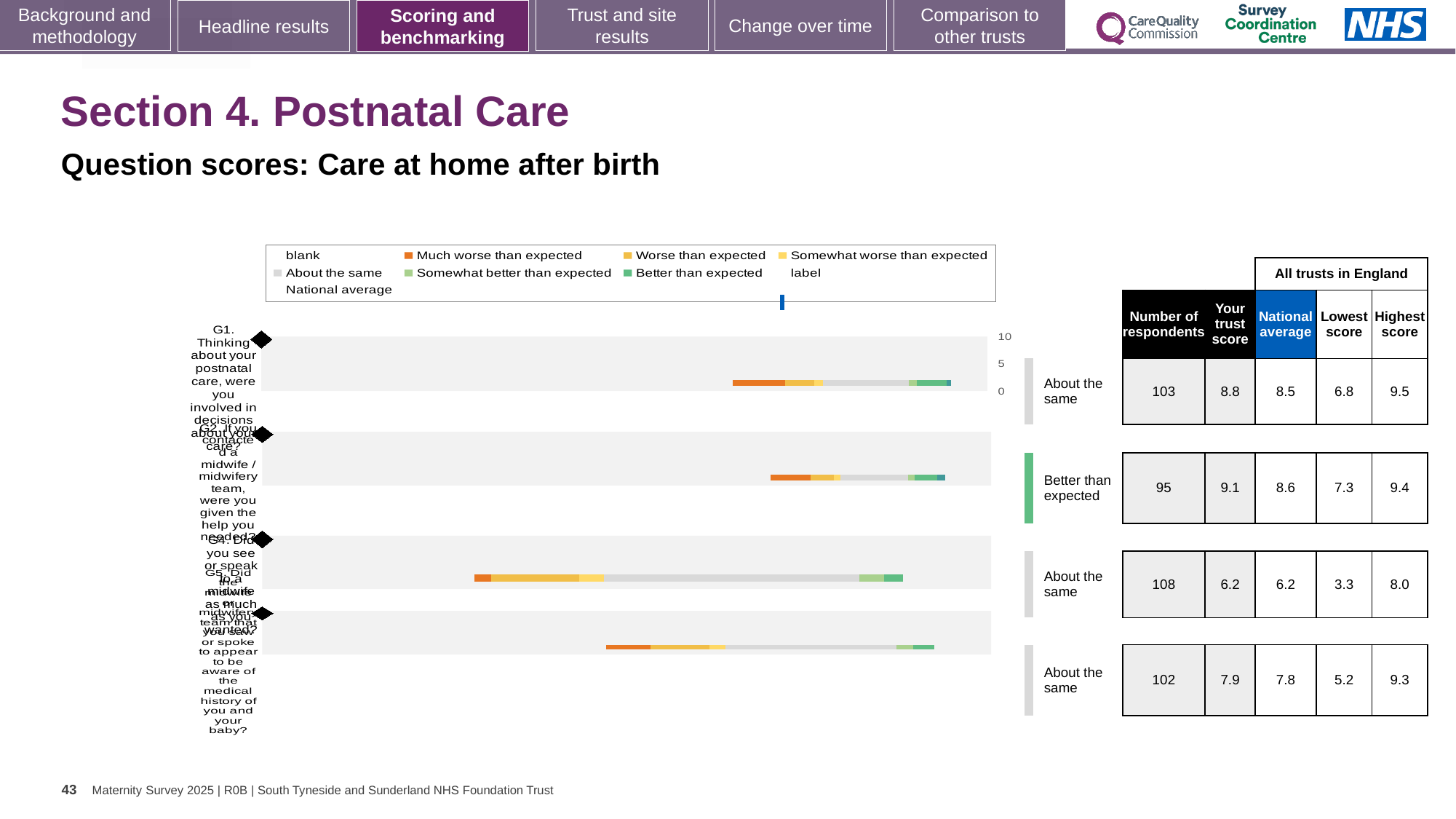
In the table, what is the trust score for the question rated 'Better than expected'? 9.1 In the table, what is the national average for the first question (G1)? 8.5 How many question bars are plotted in the chart? 4 What is the difference between the trust score and the national average for the question rated 'Better than expected'? 0.5 Which colour in the legend represents 'Much worse than expected'? orange Which question has the lowest 'Your trust score' in the table? the third question (6.2) In the table, what is the lowest score for the third question? 3.3 How many of the four questions are rated 'About the same'? 3 Which colour in the legend represents 'Better than expected'? green In the table, what is the number of respondents for the first question (G1)? 103 For the first question (G1), which is larger: the trust score or the national average? the trust score (8.8) What kind of chart is shown on the slide? bar chart